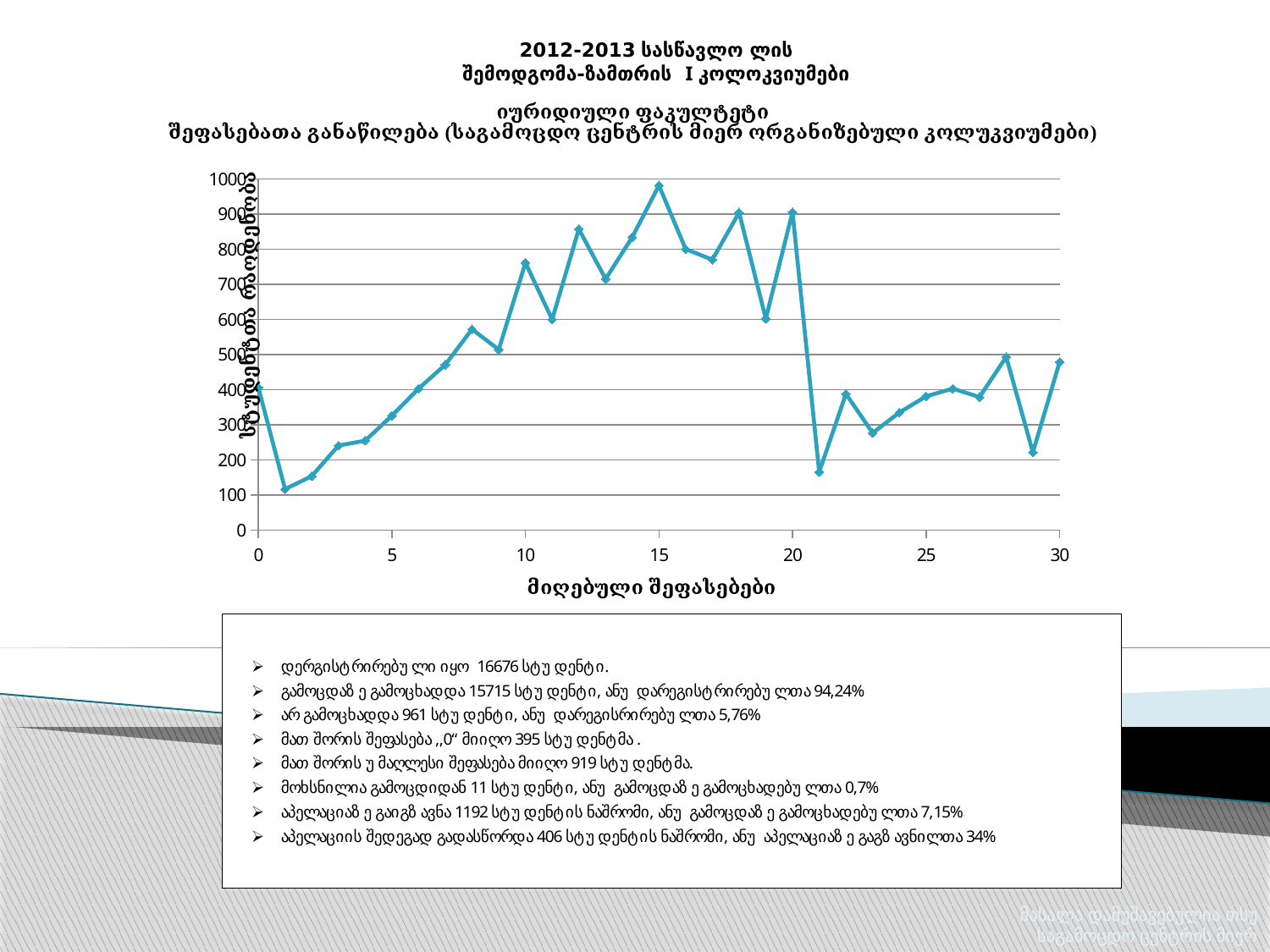
At which x-axis value (score) does the line reach its highest point? 15 Does the line rise or fall between x = 20 and x = 21? fall Which is larger, the value at x = 15 or the value at x = 20? x = 15 Is the value at x = 10 greater or less than 700? greater What is the title of the x axis? მიღებული შეფასებები What kind of chart is shown on the slide? line chart Which is larger, the value at x = 10 or the value at x = 11? x = 10 At which x-axis value (score) does the line reach its lowest point? 1 Is the value at x = 21 greater or less than 200? less Is the value at x = 1 greater or less than 200? less